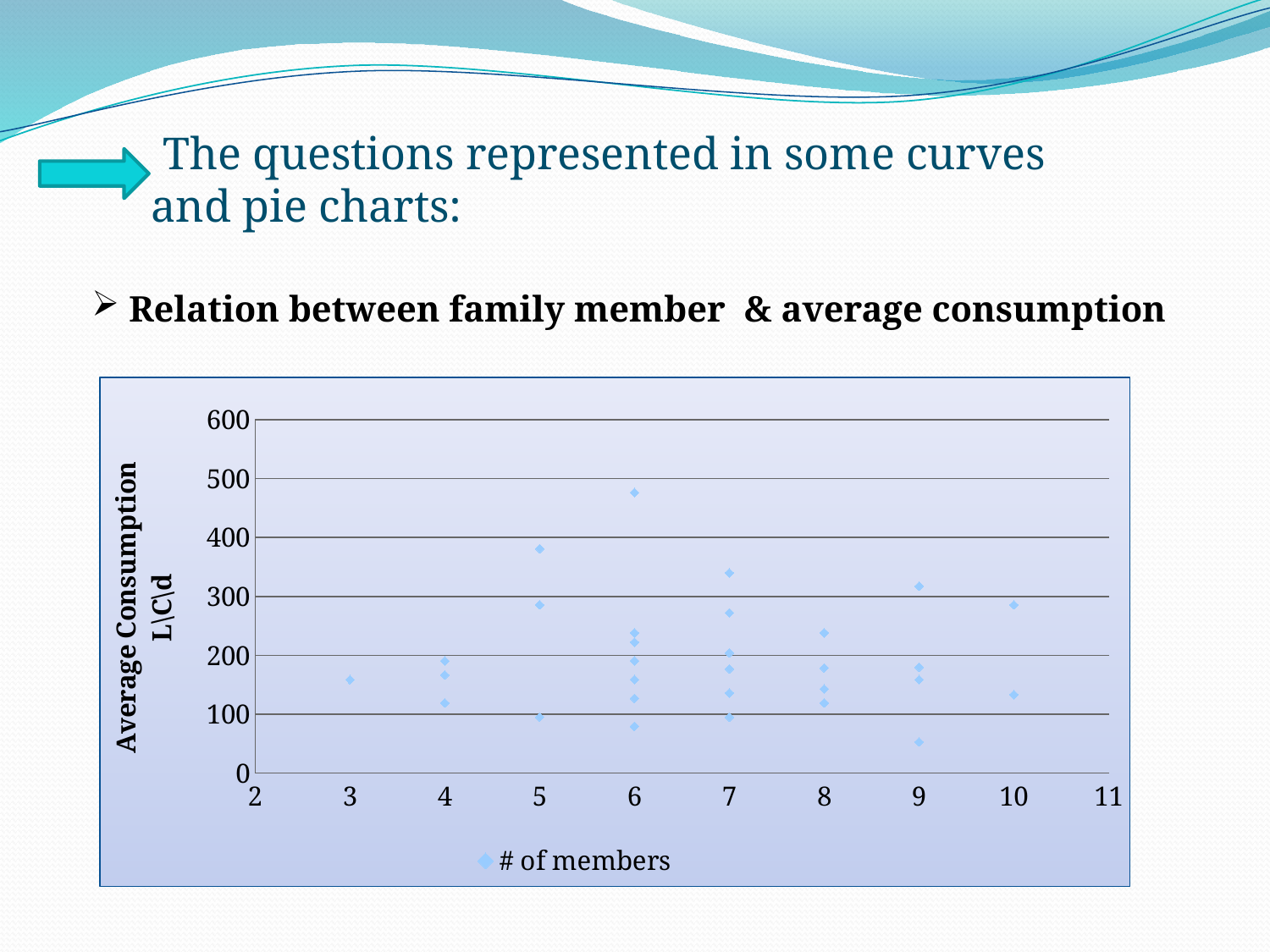
What kind of chart is shown on the slide? scatter chart What is the legend entry shown below the chart? # of members Is the single plotted point for 3 members greater or less than 100? greater At which number of members does the lowest plotted point on the chart occur? 9 How many points are plotted for 10 members? 2 Is the highest plotted point for 6 members greater or less than 400? greater Is the single plotted point for 3 members greater or less than 200? less What is the title of the vertical axis? Average Consumption L\C\d How many points are plotted for 3 members? 1 How many series does the chart legend list? 1 At which number of members does the highest plotted point on the chart occur? 6